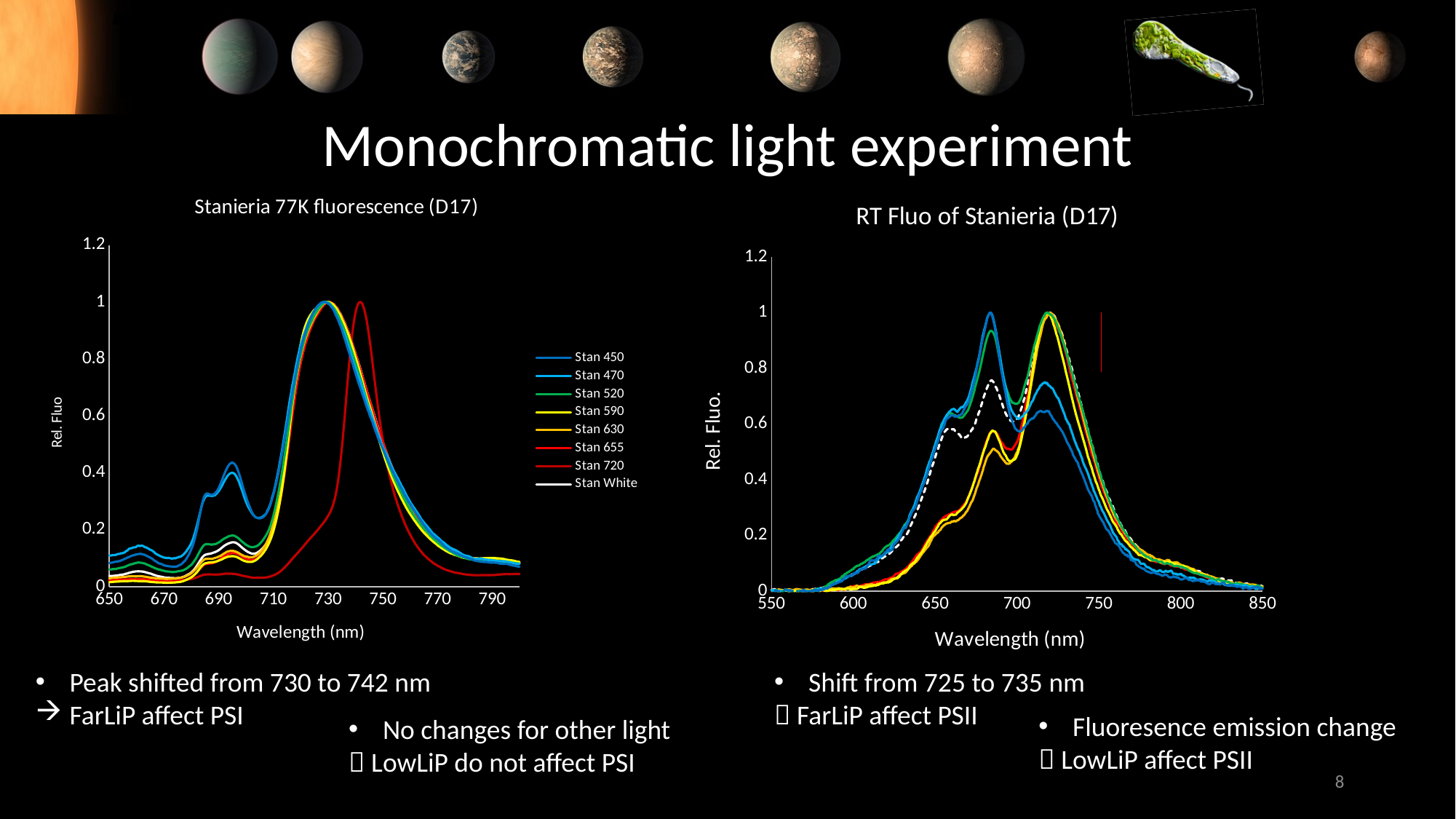
In the left chart 'Stanieria 77K fluorescence (D17)', is the value of the Stan 655 series at 770 nm greater or less than 0.2? less In the left chart 'Stanieria 77K fluorescence (D17)', is the value of the Stan 450 series at its secondary peak near 695 nm greater or less than 0.2? greater In the left chart 'Stanieria 77K fluorescence (D17)', how many series does the legend list? 8 In the right chart 'RT Fluo of Stanieria (D17)', do the values rise or fall along the x axis between 750 nm and 850 nm? Fall In the left chart 'Stanieria 77K fluorescence (D17)', what is the label of the x axis? Wavelength (nm) What kind of chart is the left chart titled 'Stanieria 77K fluorescence (D17)'? Line chart In the right chart 'RT Fluo of Stanieria (D17)', is the value of the dashed white series at 650 nm greater or less than 0.4? greater In the right chart 'RT Fluo of Stanieria (D17)', what is the label of the y axis? Rel. Fluo. What kind of chart is the right chart titled 'RT Fluo of Stanieria (D17)'? Line chart In the left chart 'Stanieria 77K fluorescence (D17)', which series peaks at a longer wavelength than the others, Stan 655 or Stan 450? Stan 655